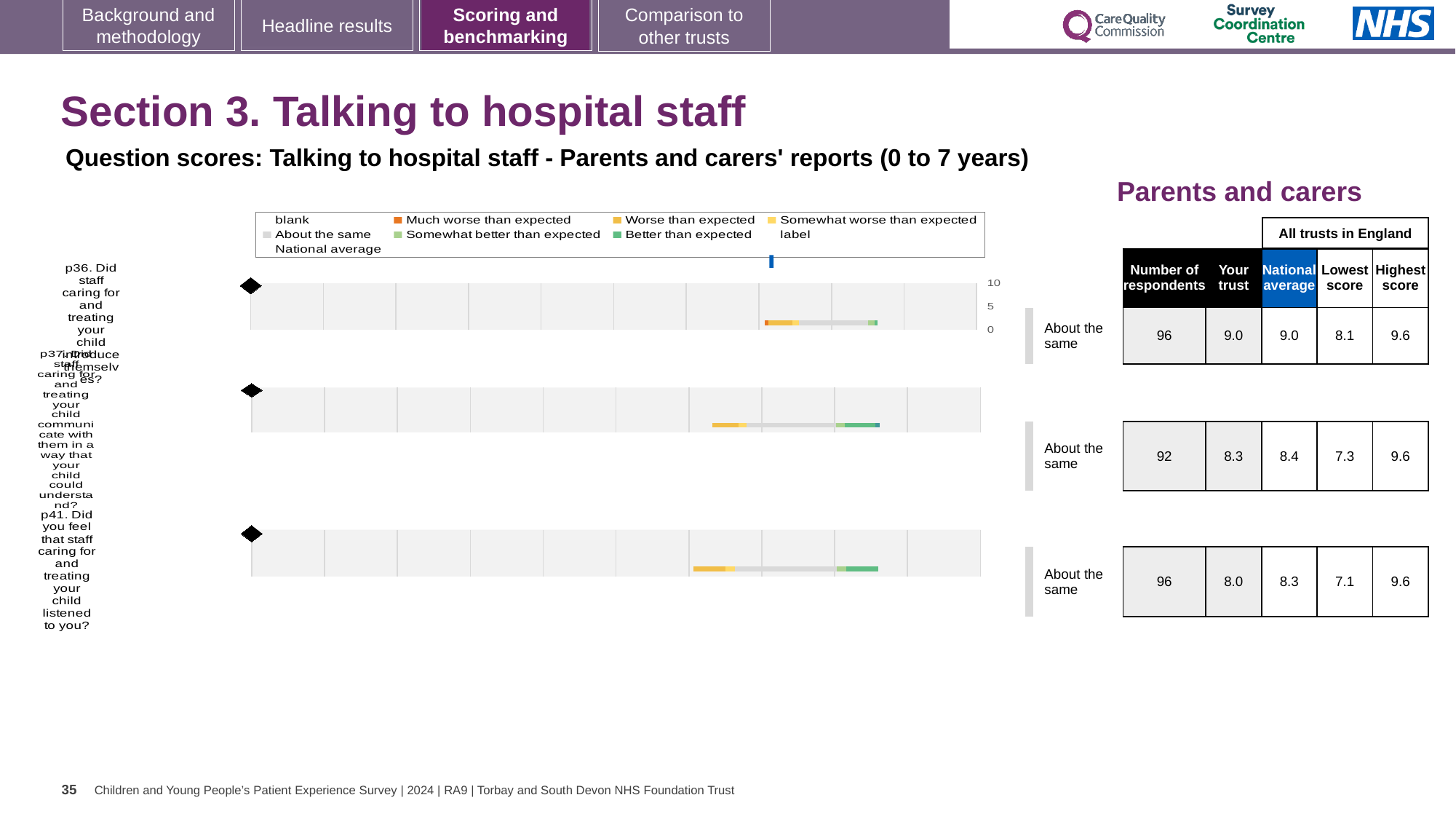
How many survey questions (p36, p37, p41) have a benchmark chart on this slide? 3 For p41, what is the difference between the National average (8.3) and the Your trust score (8.0)? 0.3 Which question has the highest 'Your trust' score in the table beside the charts? p36 What kind of chart is used to show the question scores on this slide? bar chart In the table beside the charts, how many respondents answered p37 (Did staff communicate with your child in a way they could understand)? 92 In the table beside the charts, what is the lowest score across all trusts in England for p41 (Did you feel that staff listened to you)? 7.1 For p37, which is larger: the 'Your trust' score or the 'National average'? National average What is the highest tick value shown on the axis of the top chart? 10 What benchmark category label is shown next to each of the three charts? About the same In the table beside the charts, what is the highest score across all trusts in England for p36? 9.6 In the legend, what colour represents 'Better than expected'? green In the table beside the charts, what is the 'Your trust' score for p36 (Did staff caring for and treating your child introduce themselves)? 9.0